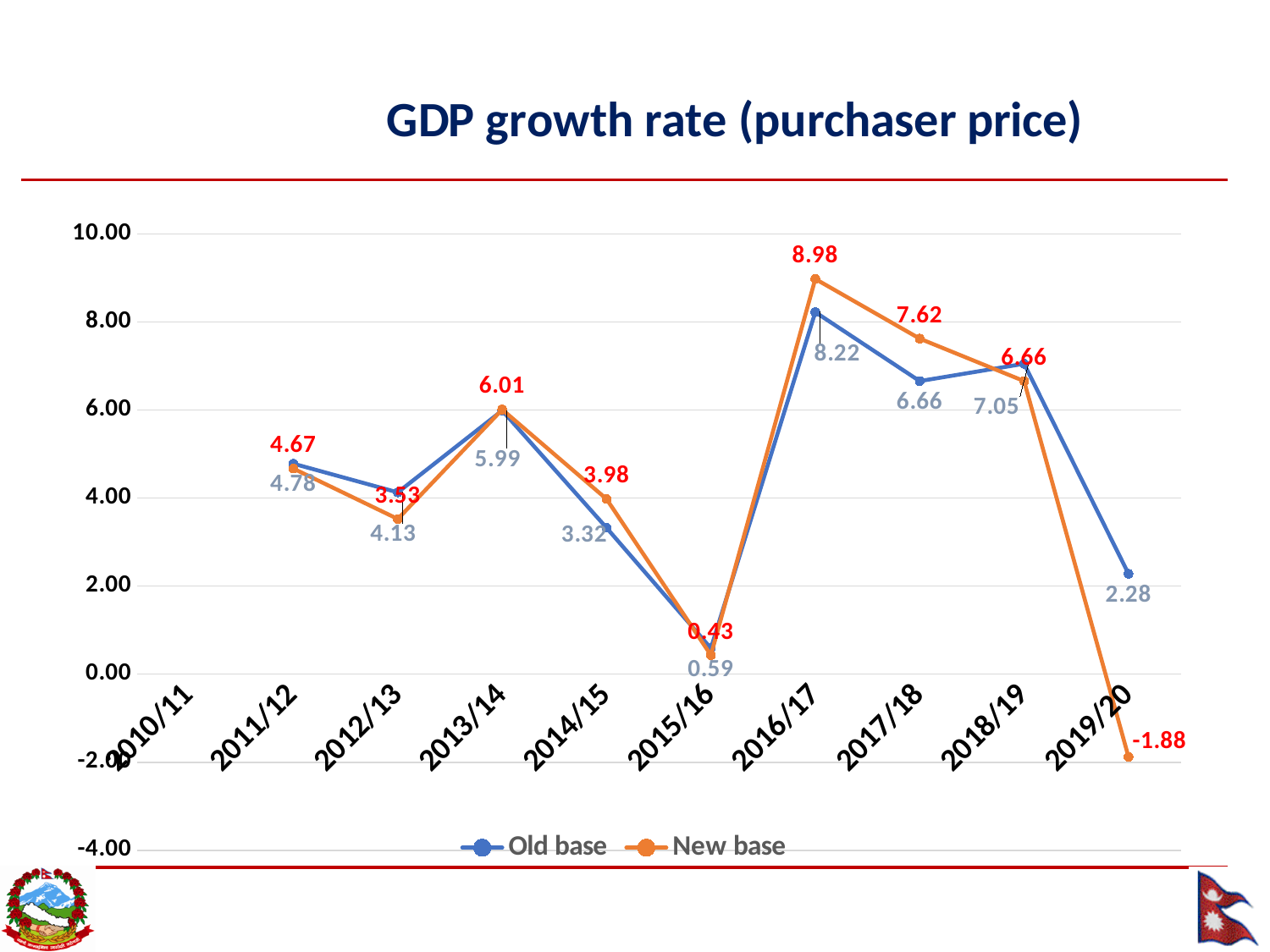
In 2014/15, which series has the higher value, Old base or New base? New base How many series does the legend list? 2 In which year does the Old base series reach its highest value? 2016/17 What is the New base value for 2019/20? -1.88 By how much does the Old base value exceed the New base value in 2019/20? 4.16 What is the Old base value for 2015/16? 0.59 What is the difference between the New base and Old base values in 2016/17? 0.76 What kind of chart is shown on the slide? Line chart What is the New base GDP growth rate for 2016/17? 8.98 Does the New base series rise or fall from 2016/17 to 2019/20? Fall What is the Old base GDP growth rate for 2019/20? 2.28 In which year is the New base series at its lowest? 2019/20